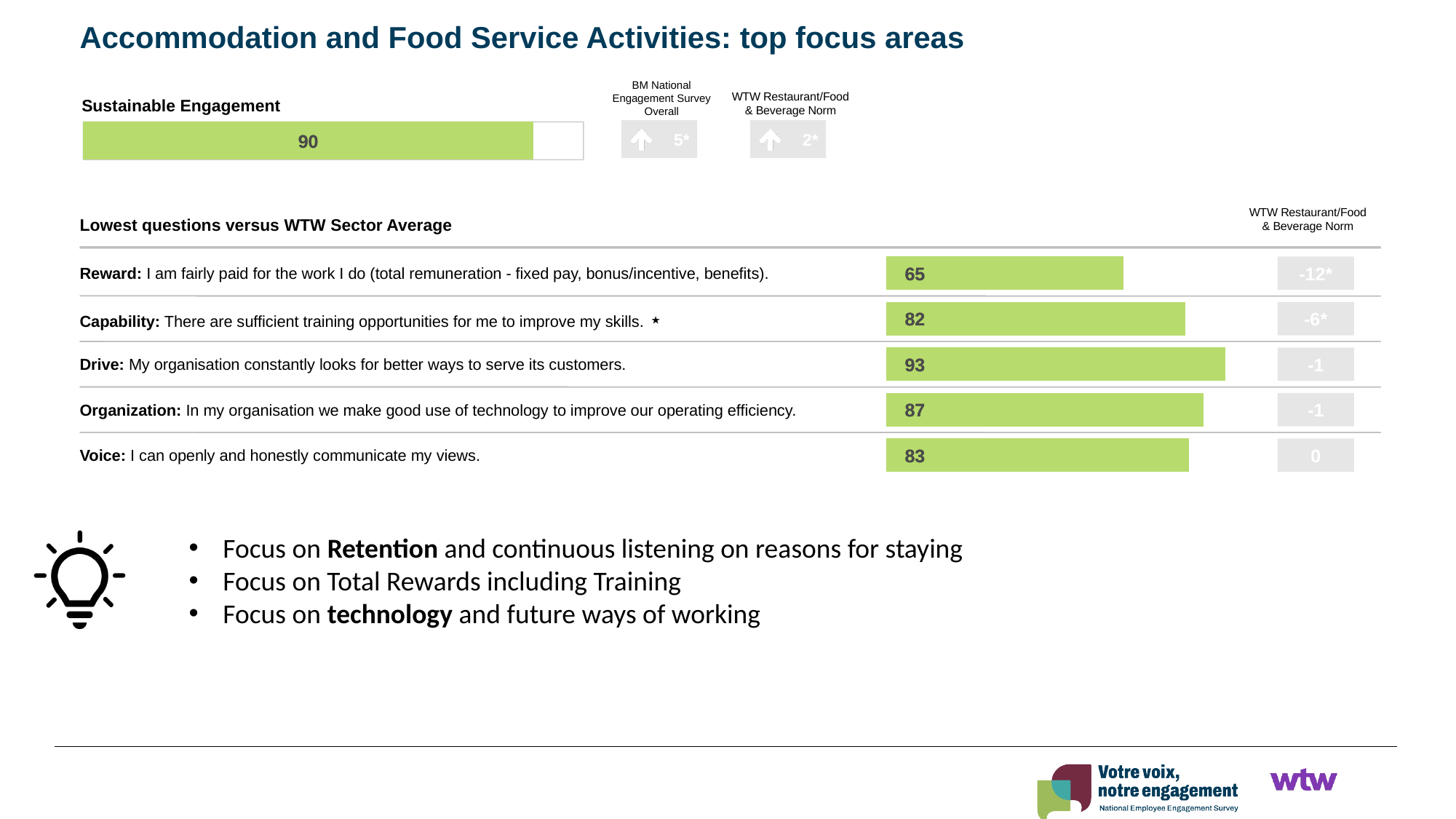
In the Lowest questions versus WTW Sector Average chart, which question has the highest score? Drive In the Sustainable Engagement chart, what is the difference shown versus the WTW Restaurant/Food & Beverage Norm? 2* What kind of chart is used for the Lowest questions versus WTW Sector Average section? Bar chart How many questions are shown in the Lowest questions versus WTW Sector Average chart? 5 In the Lowest questions versus WTW Sector Average chart, what is the value for Voice? 83 In the Lowest questions versus WTW Sector Average chart, what is the WTW Restaurant/Food & Beverage Norm difference shown for Reward? -12* In the Lowest questions versus WTW Sector Average chart, which has a higher score, Voice or Capability? Voice In the Sustainable Engagement chart, what is the score shown on the bar? 90 In the Lowest questions versus WTW Sector Average chart, what is the value for Reward? 65 In the Lowest questions versus WTW Sector Average chart, what is the value for Drive? 93 In the Lowest questions versus WTW Sector Average chart, what is the difference between the Organization score and the Capability score? 5 In the Lowest questions versus WTW Sector Average chart, which question has the lowest score? Reward